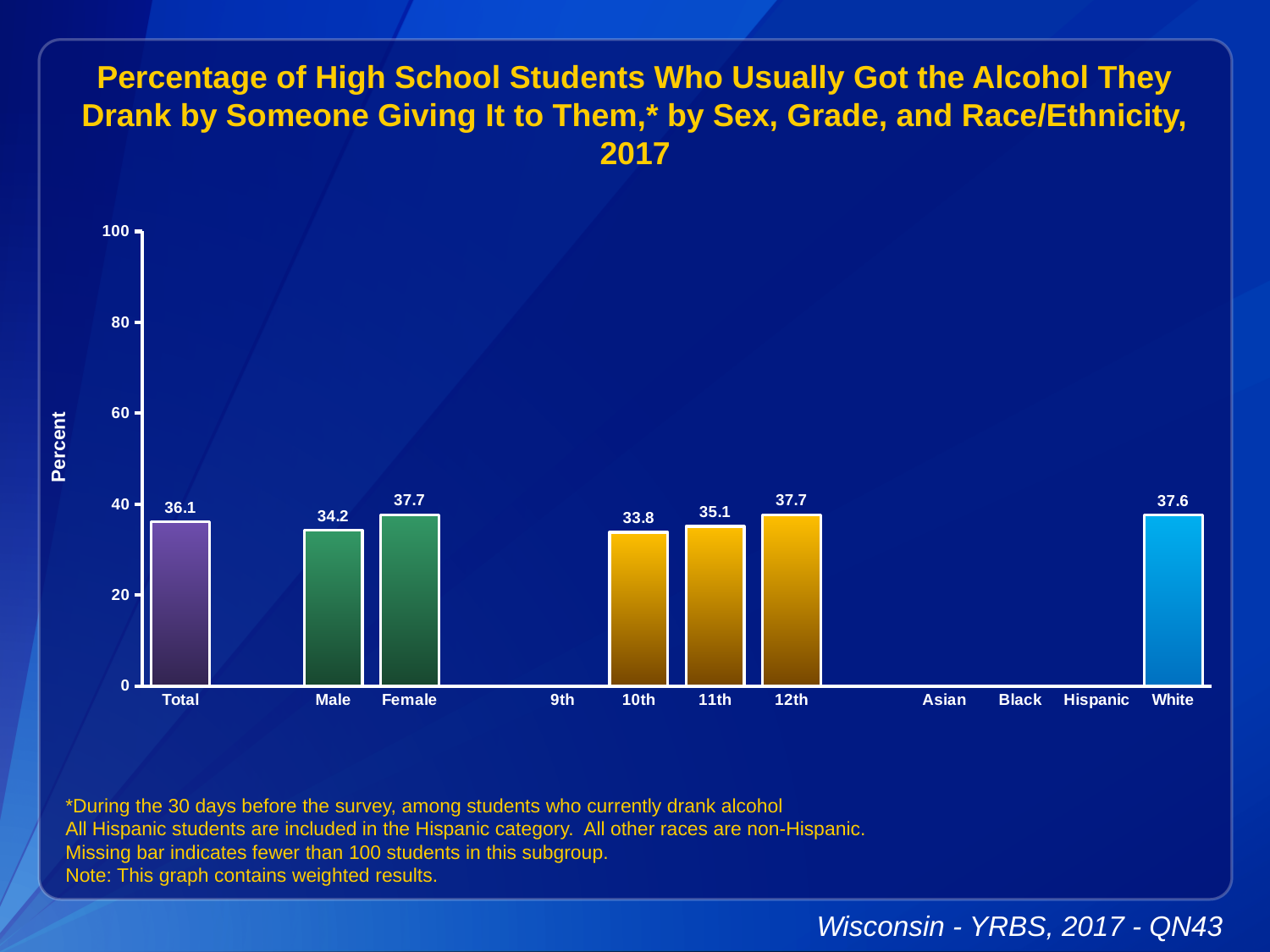
What is the difference between the Female value and the Male value? 3.5 Is the value for 11th grade greater or less than 40? less How many categories on the x axis have no bar shown? 4 What is the value for White? 37.6 What is the difference between the 12th grade value and the 10th grade value? 3.9 Do the values rise or fall from 10th grade to 12th grade? rise Which grade has the lowest value among the grades with bars shown? 10th What is the value for Total? 36.1 Which is larger, the value for Male or the value for Female? Female What is the value for Male? 34.2 What is the value for 10th grade? 33.8 What kind of chart is shown on the slide? bar chart